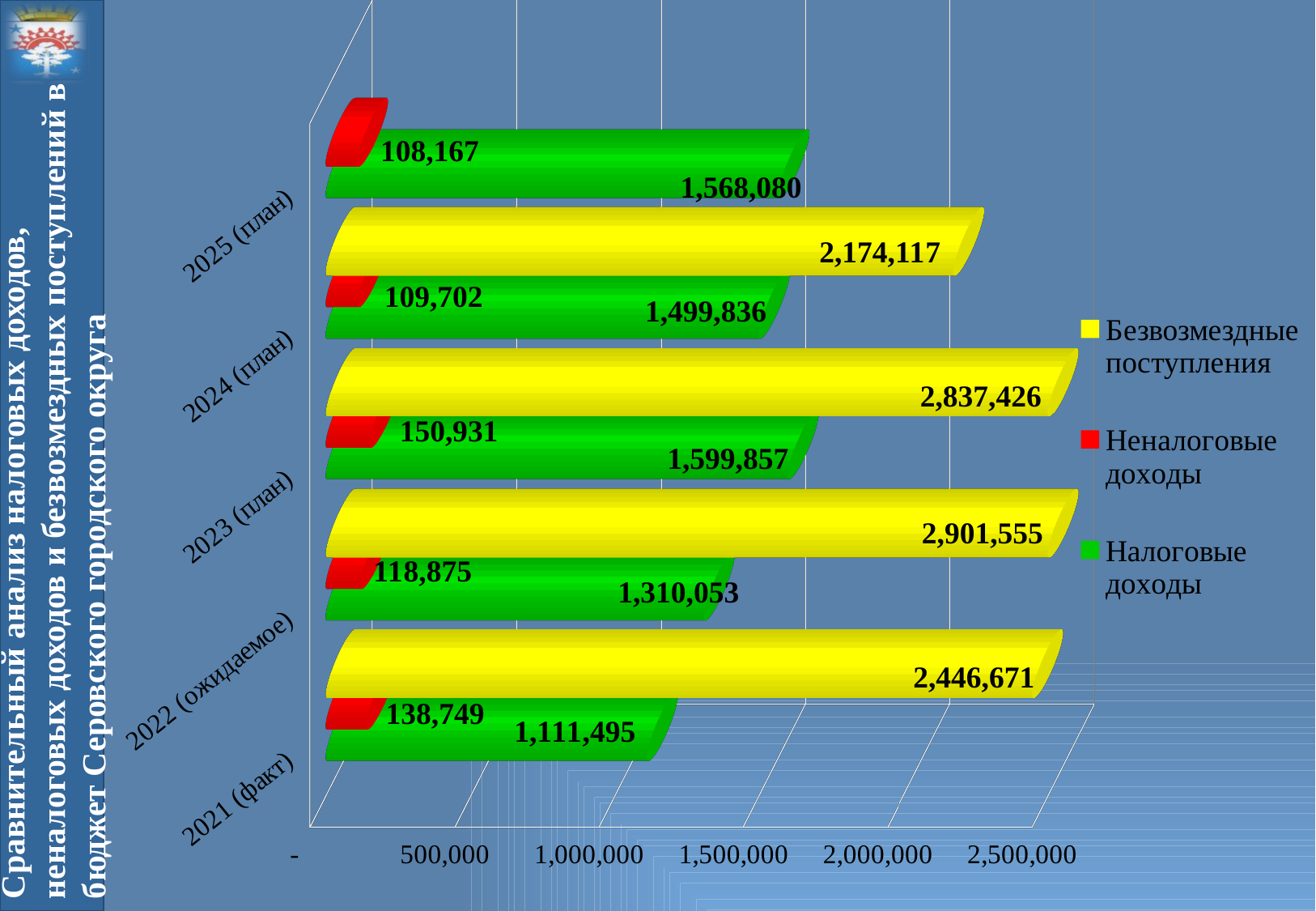
Which is larger: Безвозмездные поступления in 2023 (план) or in 2024 (план)? 2023 (план) Which category has the lowest value of Неналоговые доходы? 2025 (план) What kind of chart is shown on the slide? bar chart What is the value of Неналоговые доходы for 2023 (план)? 150,931 How many categories are shown on the vertical axis? 5 What is the value of Налоговые доходы for 2025 (план)? 1,568,080 How many series does the legend list? 3 Which category has the highest value of Безвозмездные поступления? 2022 (ожидаемое) What is the value of Безвозмездные поступления for 2022 (ожидаемое)? 2,901,555 Which colour represents Неналоговые доходы in the legend? red What is the value of Налоговые доходы for 2021 (факт)? 1,111,495 What is the difference between Налоговые доходы in 2023 (план) and 2022 (ожидаемое)? 289,804